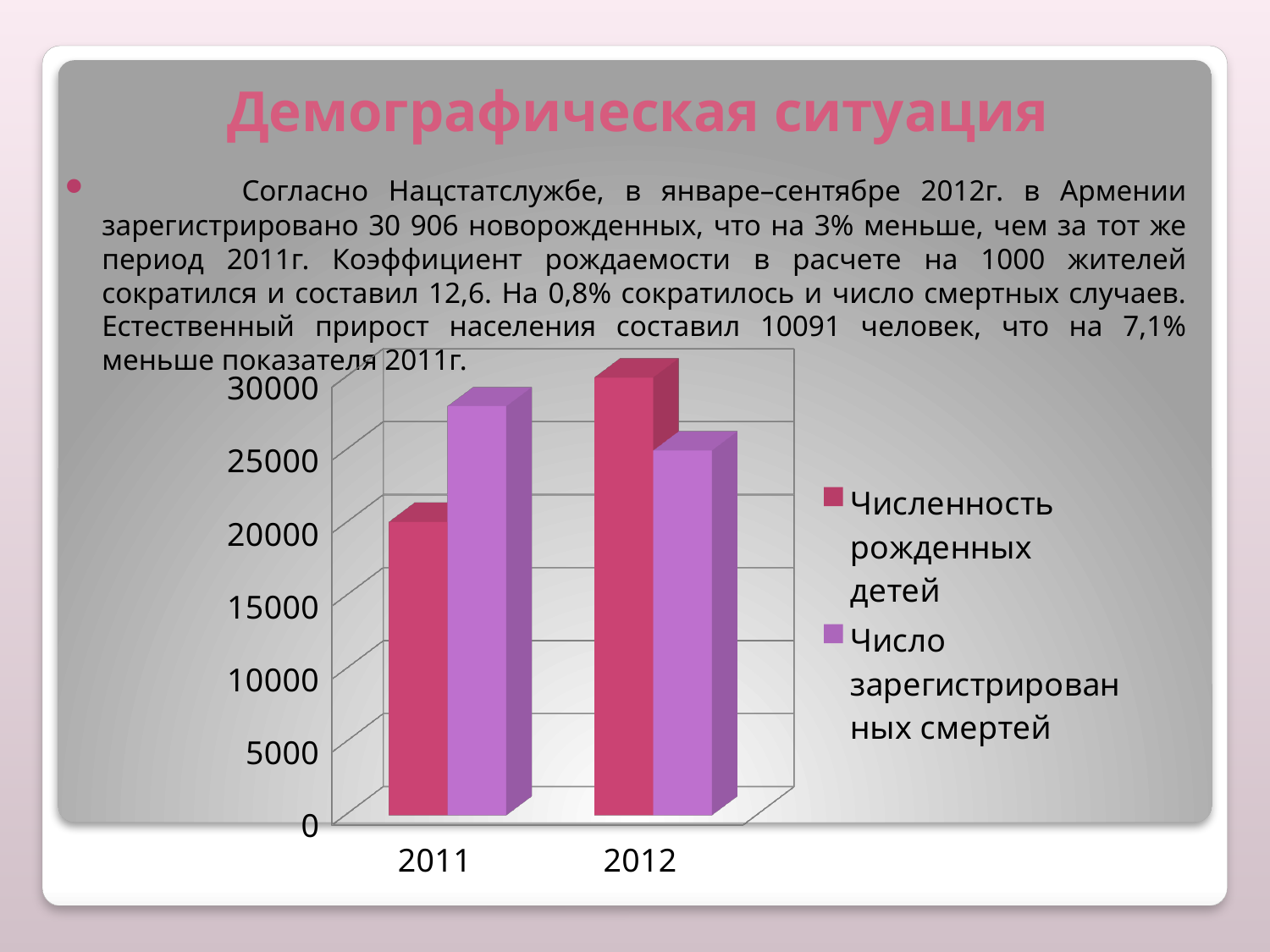
In 2011, which is larger: Численность рожденных детей or Число зарегистрированных смертей? Число зарегистрированных смертей In 2012, which is larger: Численность рожденных детей or Число зарегистрированных смертей? Численность рожденных детей How many series does the chart legend list? 2 Which years are shown on the x axis of the chart? 2011 and 2012 Does the value for Численность рожденных детей rise or fall from 2011 to 2012? rise Which series is shown in purple in the chart? Число зарегистрированных смертей What kind of chart is shown on the slide? bar chart How many categories (years) are shown on the x axis of the chart? 2 Is the value for Число зарегистрированных смертей in 2011 greater or less than 25000? greater Is the value for Число зарегистрированных смертей in 2012 greater or less than 30000? less Is the value for Численность рожденных детей in 2012 greater or less than 25000? greater